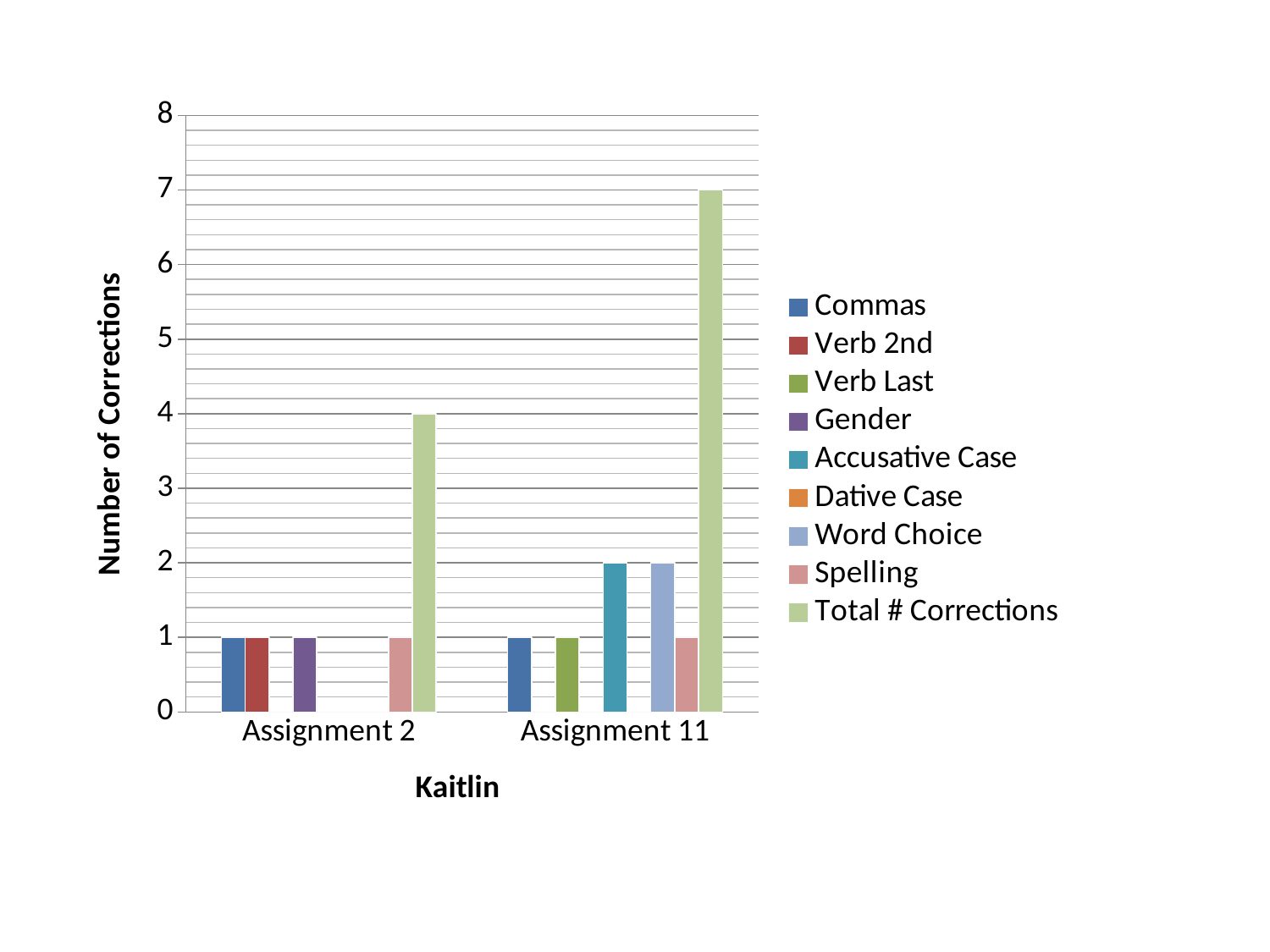
Is the Total # Corrections for Assignment 11 greater or less than 6? greater What is the difference in Total # Corrections between Assignment 11 and Assignment 2? 3 What type of chart is shown on the slide? bar chart What is the Total # Corrections value for Assignment 2? 4 How many series does the legend list? 9 What is the label of the y axis? Number of Corrections What is the label of the x axis? Kaitlin What is the Total # Corrections value for Assignment 11? 7 How many Accusative Case corrections are shown for Assignment 11? 2 How many assignment categories are shown on the x axis? 2 How many Word Choice corrections are shown for Assignment 11? 2 Which assignment has the higher Total # Corrections? Assignment 11